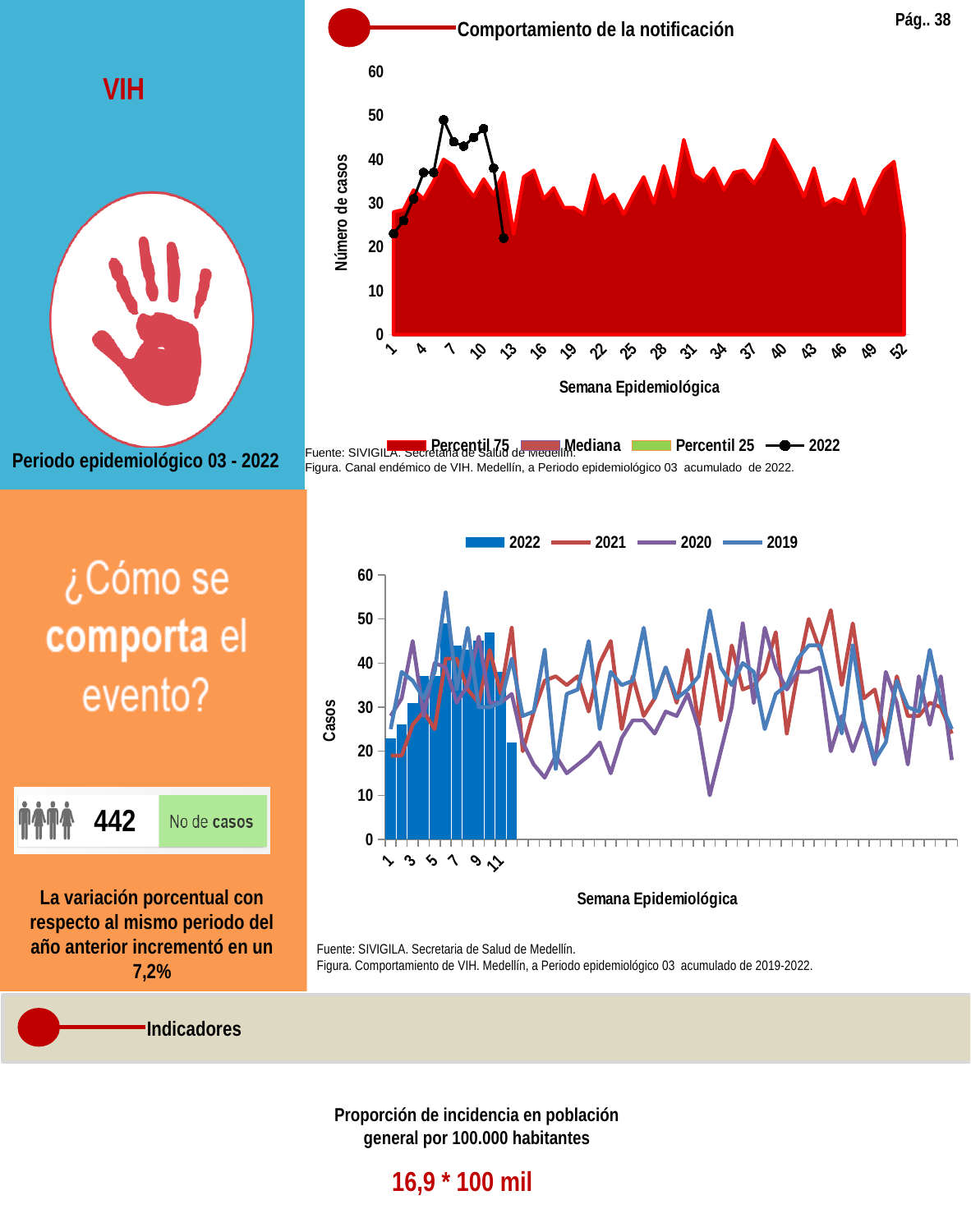
In the top chart titled 'Comportamiento de la notificación', does the 2022 line rise or fall from week 1 to week 6? rise In the top chart titled 'Comportamiento de la notificación', which is larger for 2022: the value at week 6 or the value at week 1? week 6 In the top chart titled 'Comportamiento de la notificación', is the 2022 value at week 6 greater or less than 40? greater In the bottom chart (Comportamiento de VIH 2019-2022), how many series does the legend list? 4 In the bottom chart (Comportamiento de VIH 2019-2022), is the 2022 bar at week 6 greater or less than 40? greater In the top chart titled 'Comportamiento de la notificación', how many series does the legend list? 4 In the bottom chart (Comportamiento de VIH 2019-2022), is the 2022 bar at week 1 greater or less than 30? less In the top chart titled 'Comportamiento de la notificación', how many weeks have a plotted 2022 data point? 12 In the bottom chart (Comportamiento de VIH 2019-2022), which year is plotted as bars rather than a line? 2022 In the bottom chart (Comportamiento de VIH 2019-2022), how many bars are plotted for 2022? 12 In the top chart titled 'Comportamiento de la notificación', what is the label of the vertical axis? Número de casos